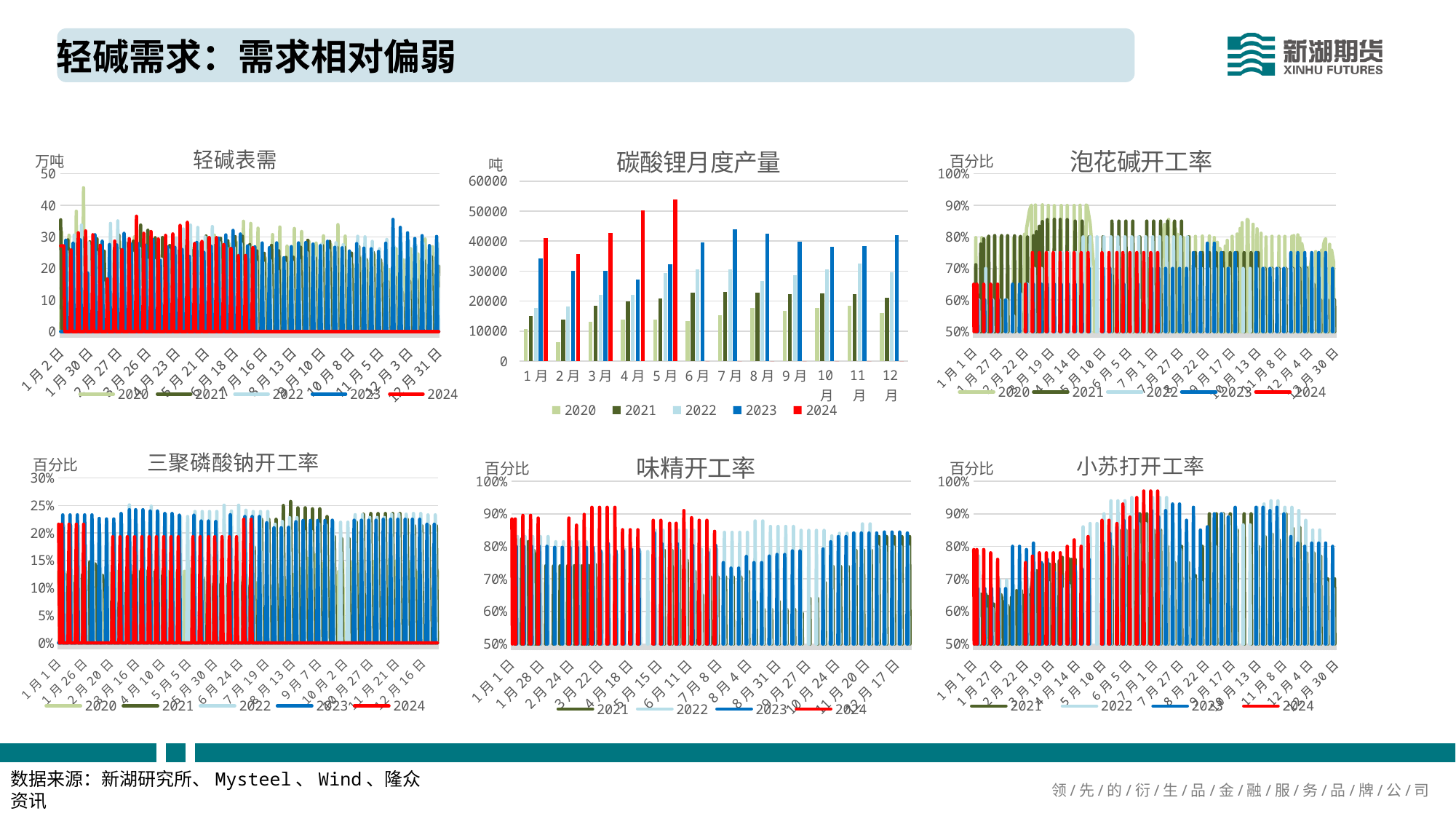
In the 碳酸锂月度产量 chart, which is larger for 2023: the 7月 value or the 4月 value? 7月 In the 碳酸锂月度产量 chart, which month has the highest 2024 bar? 5月 How many months are shown on the x axis of the 碳酸锂月度产量 chart? 12 In the 碳酸锂月度产量 chart, is the 2024 value for 5月 greater or less than 50000? greater In the 碳酸锂月度产量 chart, is the 2024 value for 2月 greater or less than 40000? less How many series does the legend of the 碳酸锂月度产量 chart list? 5 What kind of chart is the 碳酸锂月度产量 chart? bar chart In the 碳酸锂月度产量 chart, which month has the lowest 2020 bar? 2月 What unit is shown on the y axis of the 碳酸锂月度产量 chart? 吨 In the 碳酸锂月度产量 chart, which is larger for 1月: the 2024 value or the 2023 value? 2024 In the 碳酸锂月度产量 chart, is the 2023 value for 4月 greater or less than 30000? less How many series does the legend of the 味精开工率 chart list? 4